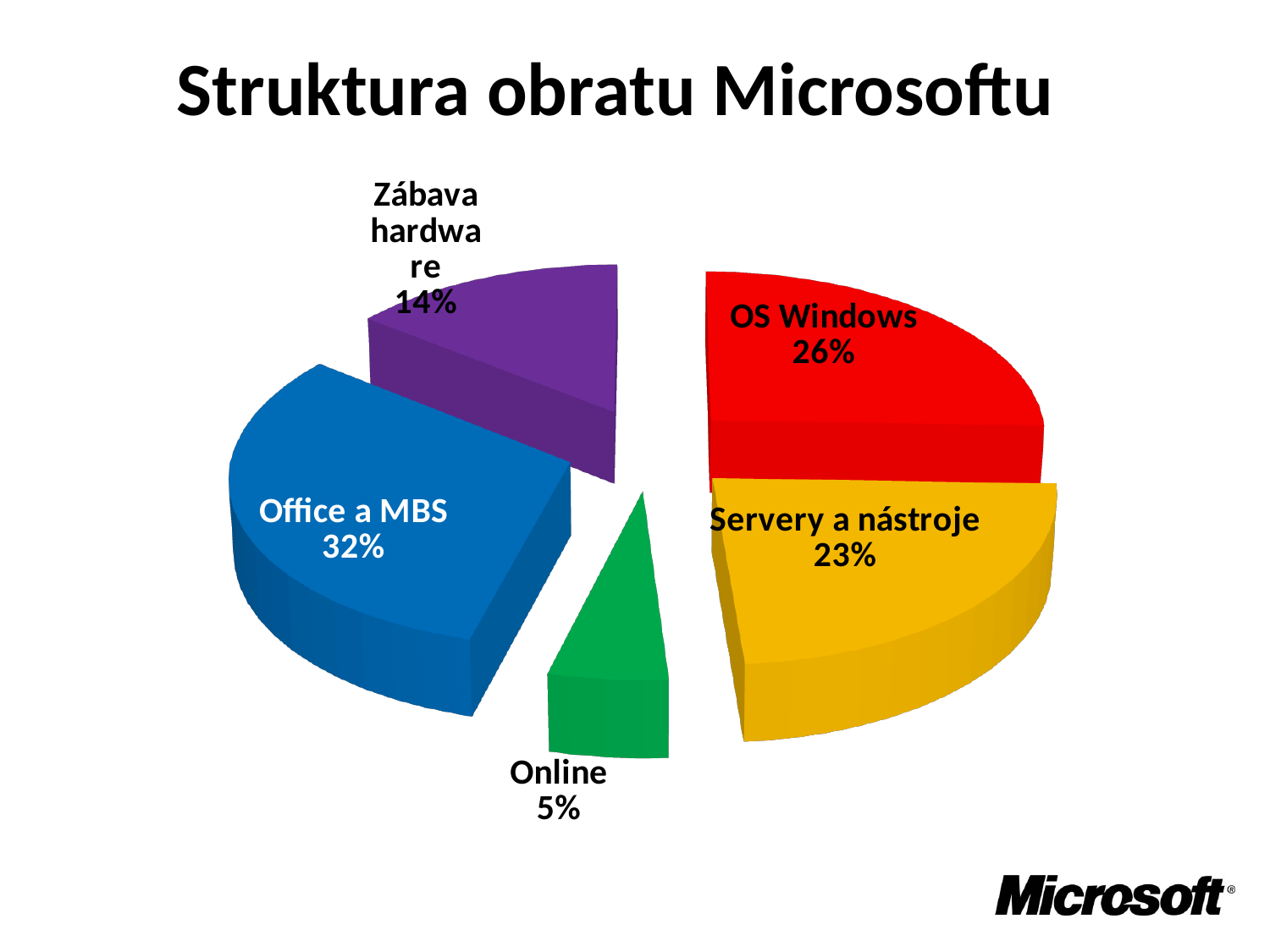
Which is larger, OS Windows or Servery a nástroje? OS Windows What is the value shown for Zábava hardware? 14% What kind of chart is shown on the slide? Pie chart Which category has the largest share of the pie? Office a MBS What is the title of the slide? Struktura obratu Microsoftu Which category has the smallest share of the pie? Online What is the value shown for Online? 5% What is the value shown for OS Windows? 26% What is the difference in percentage points between Office a MBS and OS Windows? 6 How many slices does the pie chart have? 5 What share of the pie does Office a MBS have? 32% What is the value shown for Servery a nástroje? 23%